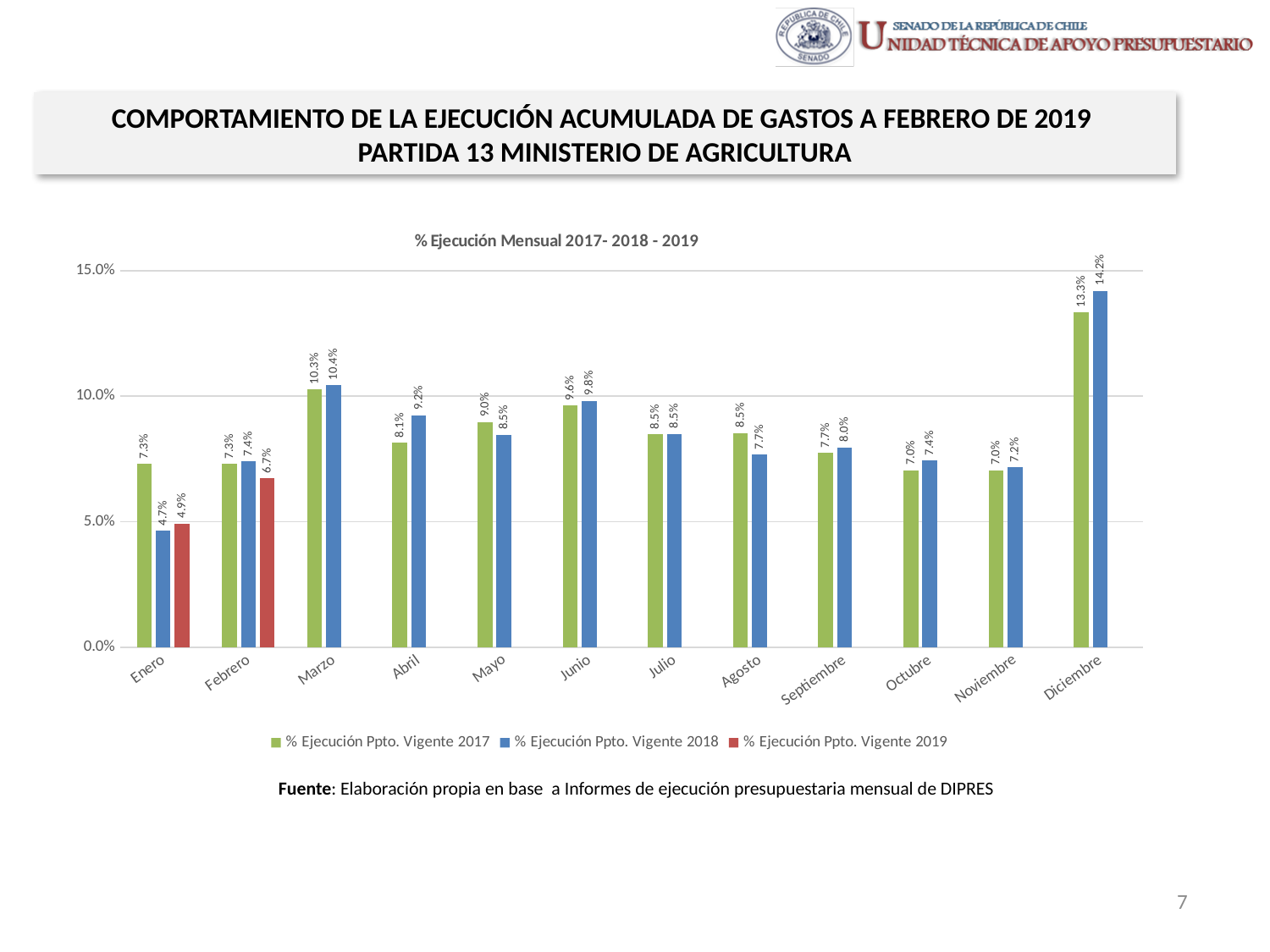
What is the value for % Ejecución Ppto. Vigente 2017 in Diciembre? 13.3% Which month has the lowest value for % Ejecución Ppto. Vigente 2018? Enero What is the value for % Ejecución Ppto. Vigente 2019 in Enero? 4.9% In Abril, which series has the larger value, 2017 or 2018? % Ejecución Ppto. Vigente 2018 How many months are shown on the x axis? 12 Which month has the highest value for % Ejecución Ppto. Vigente 2018? Diciembre What is the value for % Ejecución Ppto. Vigente 2018 in Marzo? 10.4% What is the difference between the 2018 and 2017 values in Diciembre? 0.9% What is the difference between the 2017 and 2018 values in Enero? 2.6% What is the value for % Ejecución Ppto. Vigente 2019 in Febrero? 6.7% How many series does the legend list? 3 What kind of chart is shown on the slide? Bar chart